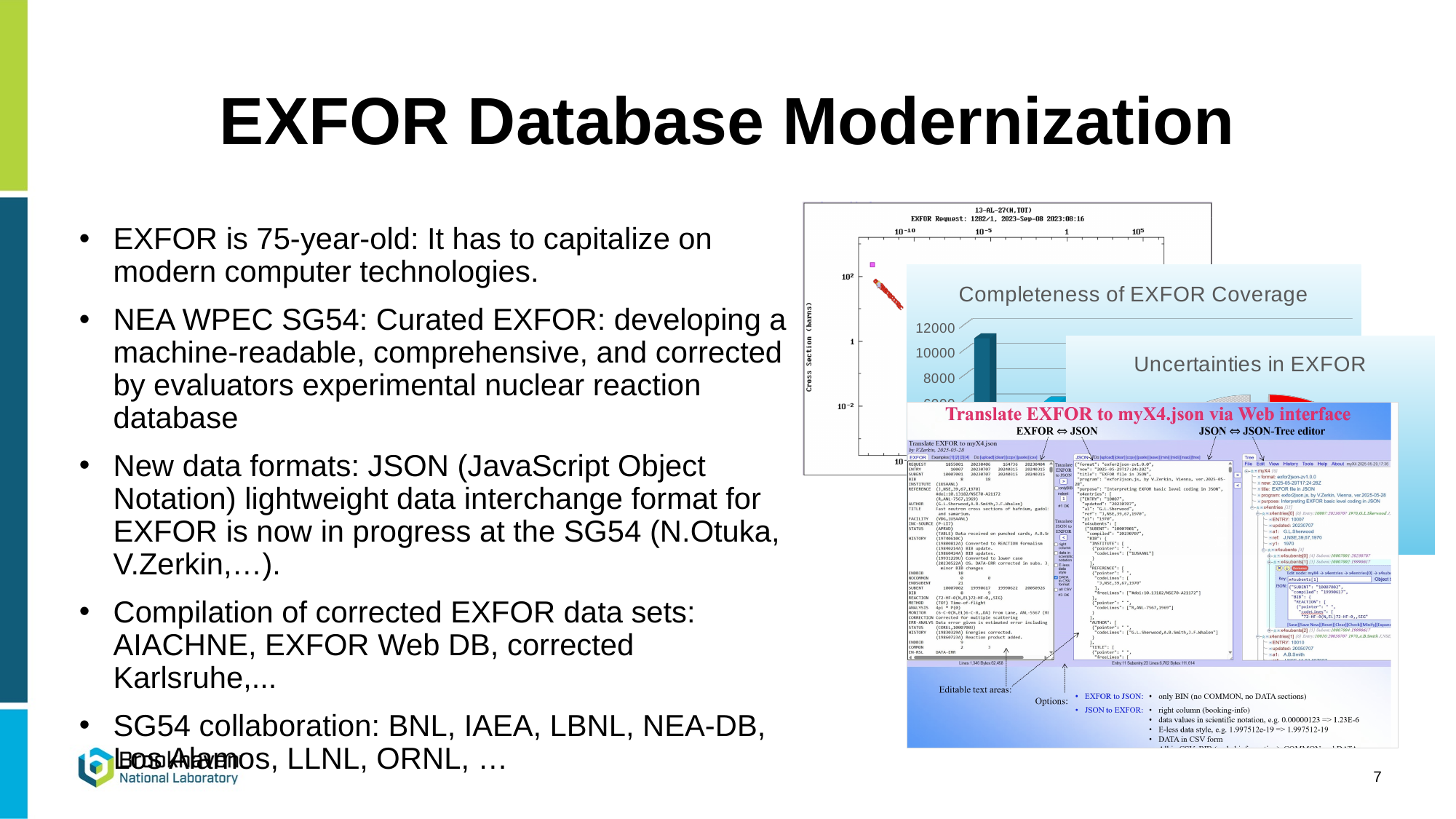
What is the title of the bar chart on the right side of the slide? Completeness of EXFOR Coverage What is the title of the chart partially visible behind the web-interface screenshot, to the right of the bar chart? Uncertainties in EXFOR In the 'Completeness of EXFOR Coverage' chart, is the value of the leftmost bar greater or less than 10000? greater In the 'Completeness of EXFOR Coverage' chart, what is the highest value labelled on the vertical axis? 12000 What kind of chart is the 'Completeness of EXFOR Coverage' chart? bar chart